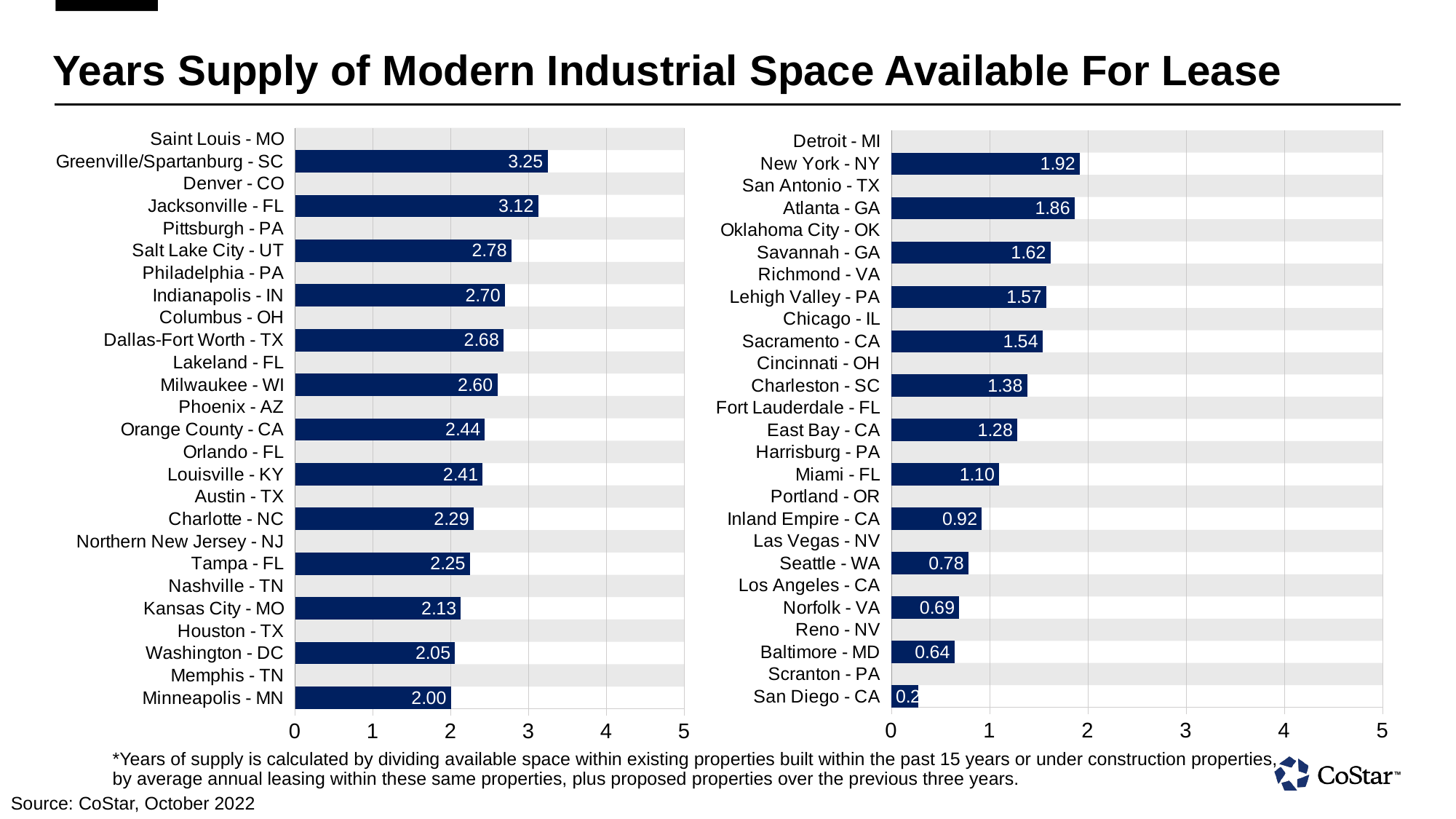
On the left chart, what is the value shown for Dallas-Fort Worth - TX? 2.68 On the left chart, what is the difference between the values for Greenville/Spartanburg - SC and Jacksonville - FL? 0.13 On the right chart, what is the value shown for Baltimore - MD? 0.64 On the right chart, which market has the lowest years supply value? San Diego - CA On the left chart, what is the years supply value for Greenville/Spartanburg - SC? 3.25 On the right chart, what is the value shown for Savannah - GA? 1.62 On the right chart, which market has the highest years supply value? New York - NY What type of chart is used on this slide? Bar chart On the left chart, which is larger, the value for Milwaukee - WI or the value for Louisville - KY? Milwaukee - WI On the right chart, is the value for Seattle - WA greater or less than 1? less On the right chart, what is the difference between the values for Savannah - GA and Charleston - SC? 0.24 On the left chart, which market has the highest years supply value? Greenville/Spartanburg - SC